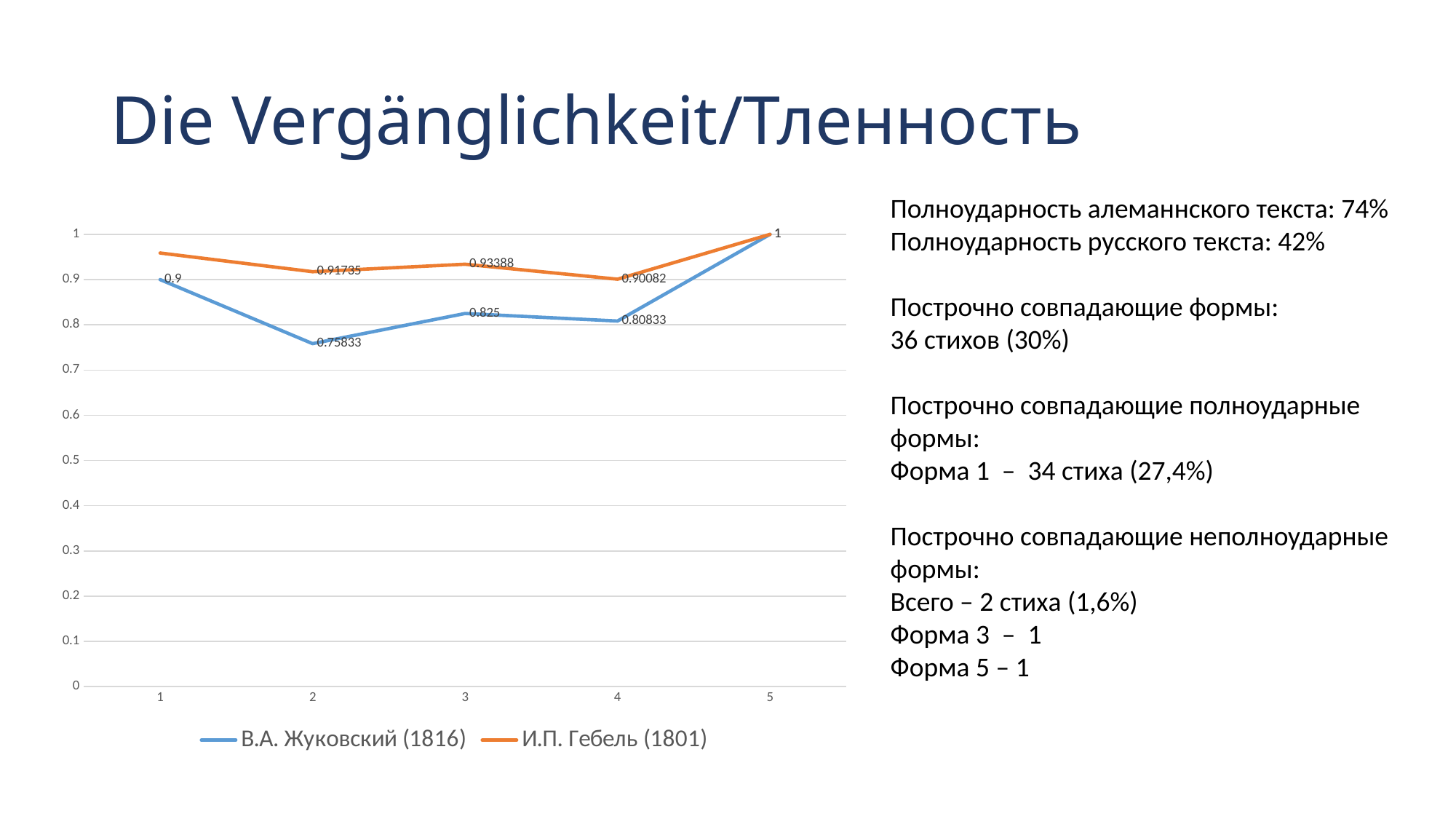
At which point on the x axis does И.П. Гебель (1801) reach its lowest value? 4 At which point on the x axis does В.А. Жуковский (1816) reach its lowest value? 2 At point 2, which series has the higher value, В.А. Жуковский (1816) or И.П. Гебель (1801)? И.П. Гебель (1801) What is the value for И.П. Гебель (1801) at point 3? 0.93388 What is the value for В.А. Жуковский (1816) at point 1? 0.9 How many series does the legend list? 2 What is the difference between И.П. Гебель (1801) and В.А. Жуковский (1816) at point 2? 0.15902 What kind of chart is shown on the slide? line chart What is the value for В.А. Жуковский (1816) at point 2? 0.75833 How many points are plotted along the x axis for each series? 5 Is the value for И.П. Гебель (1801) at point 1 greater or less than 0.9? greater What is the value for И.П. Гебель (1801) at point 4? 0.90082